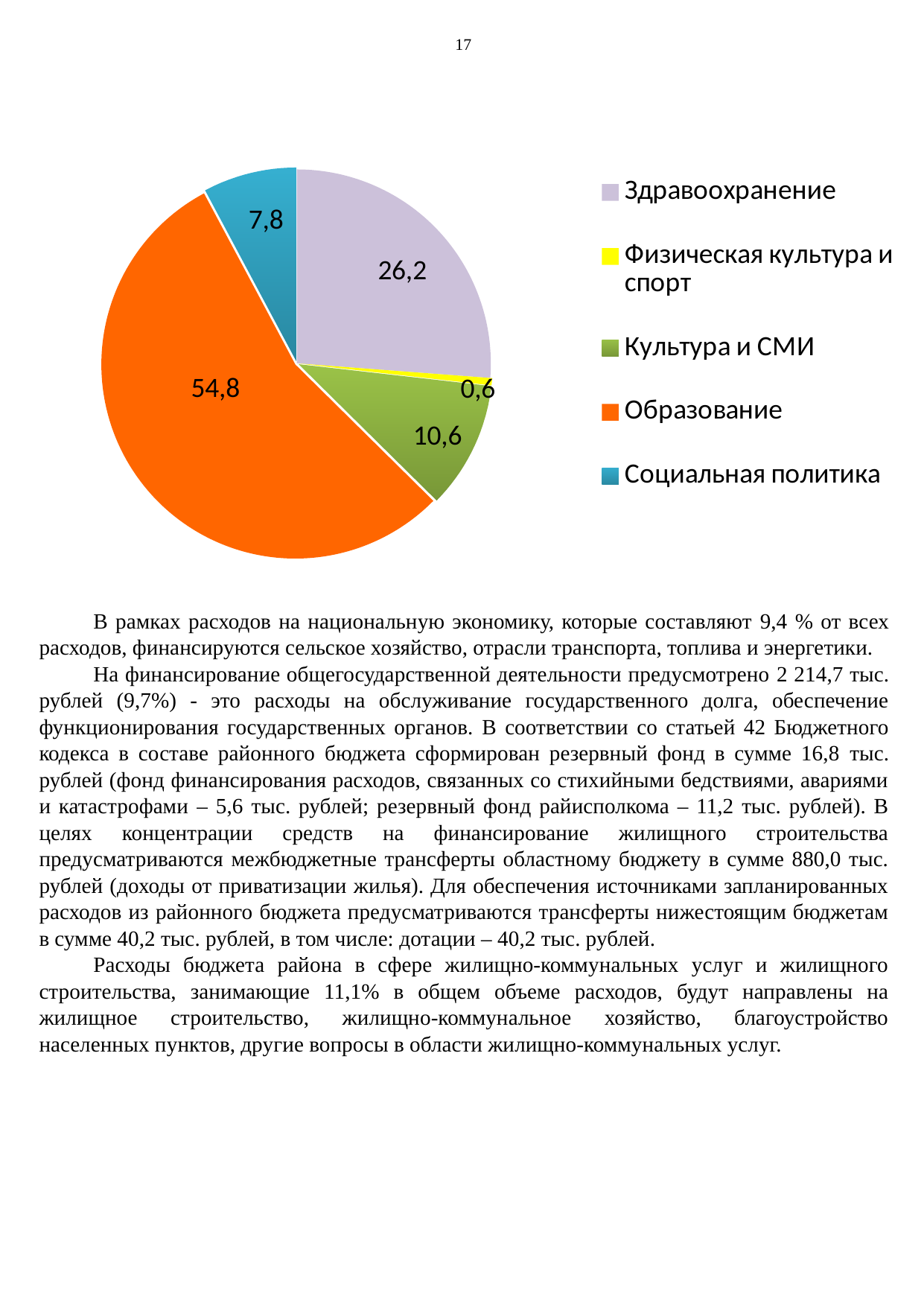
What value is shown for the Социальная политика slice? 7,8 Which is larger, the slice for Здравоохранение or the slice for Культура и СМИ? Здравоохранение How many categories does the legend of the pie chart list? 5 What type of chart is shown on the slide? Pie chart What is the difference between the values for Образование and Здравоохранение? 28,6 Which category has the smallest slice of the pie chart? Физическая культура и спорт What value is shown for the Здравоохранение slice? 26,2 What value is shown for the Культура и СМИ slice? 10,6 Which category has the largest slice of the pie chart? Образование What is the difference between the values for Культура и СМИ and Социальная политика? 2,8 What value is shown for the Образование slice of the pie chart? 54,8 What value is shown for the Физическая культура и спорт slice? 0,6